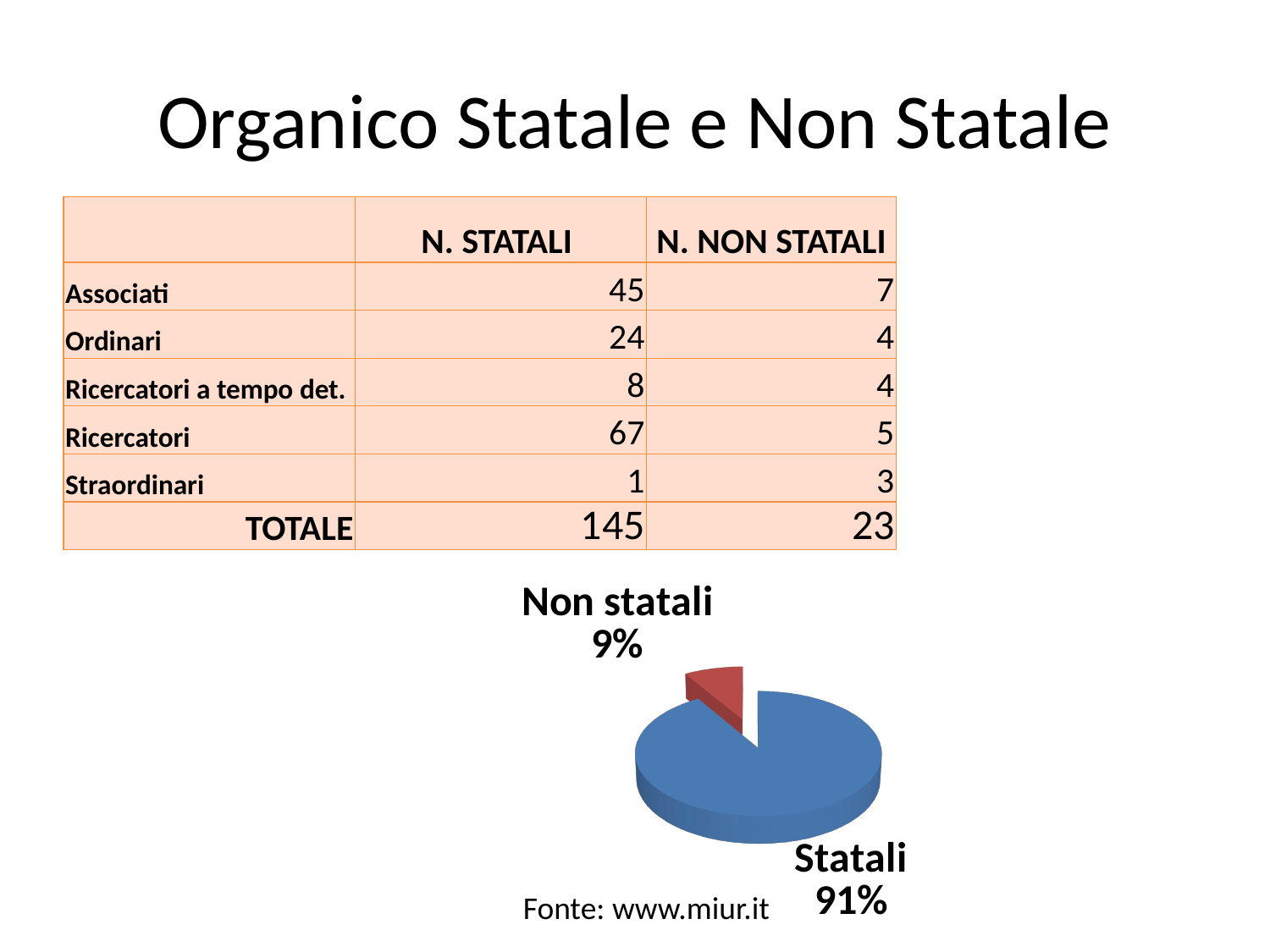
What colour is the Statali slice of the pie chart? blue How many slices does the pie chart have? 2 What is the difference in percentage points between the Statali and Non statali slices? 82 What share of the pie chart is labelled Non statali? 9% What colour is the Non statali slice of the pie chart? red Which slice of the pie chart is the largest? Statali Is the share for Statali greater or less than 50%? greater Which slice of the pie chart is the smallest? Non statali What share of the pie chart is labelled Statali? 91% What kind of chart is shown on the slide? pie chart Which is larger in the pie chart, Statali or Non statali? Statali